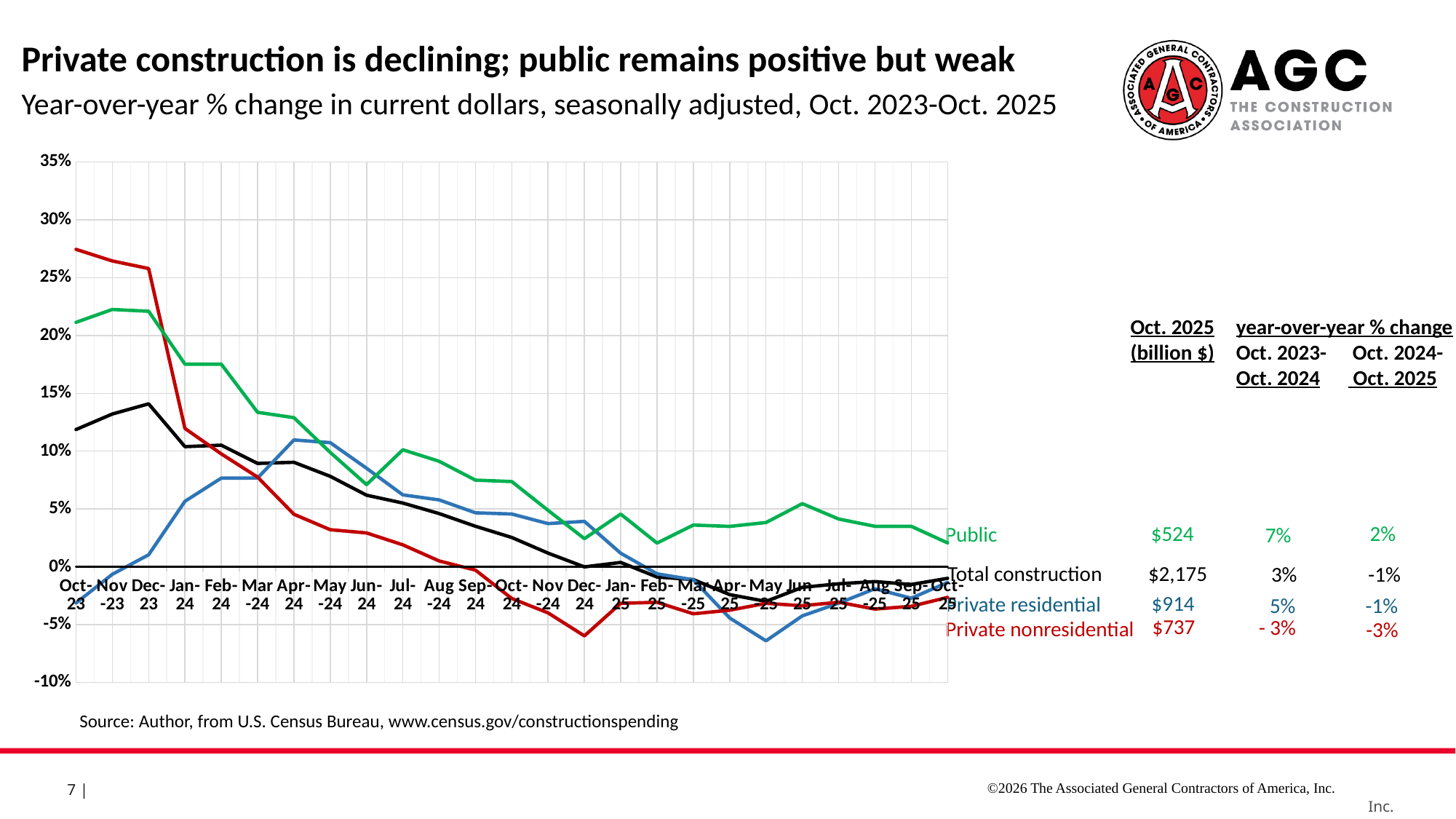
How many monthly points are shown along the x axis? 25 At Oct-25, which is larger: the year-over-year % change for Public or for Private nonresidential? Public What is the Oct. 2024-Oct. 2025 year-over-year % change for Private nonresidential construction? -3% How many series are plotted on the chart? 4 What is the Oct. 2024-Oct. 2025 year-over-year % change for Public construction? 2% Does the Private nonresidential line rise or fall from Oct-23 to Dec-24? fall Which series has the highest value at Oct-23? Private nonresidential What is the Oct. 2025 value in billion dollars for Total construction? $2,175 Is the value for Public at Dec-23 greater or less than 20%? greater By how many percentage points did the Public year-over-year % change drop from Oct. 2023-Oct. 2024 to Oct. 2024-Oct. 2025? 5 percentage points Is the value for Private nonresidential at Oct-23 greater or less than 25%? greater What kind of chart is shown on the slide? line chart